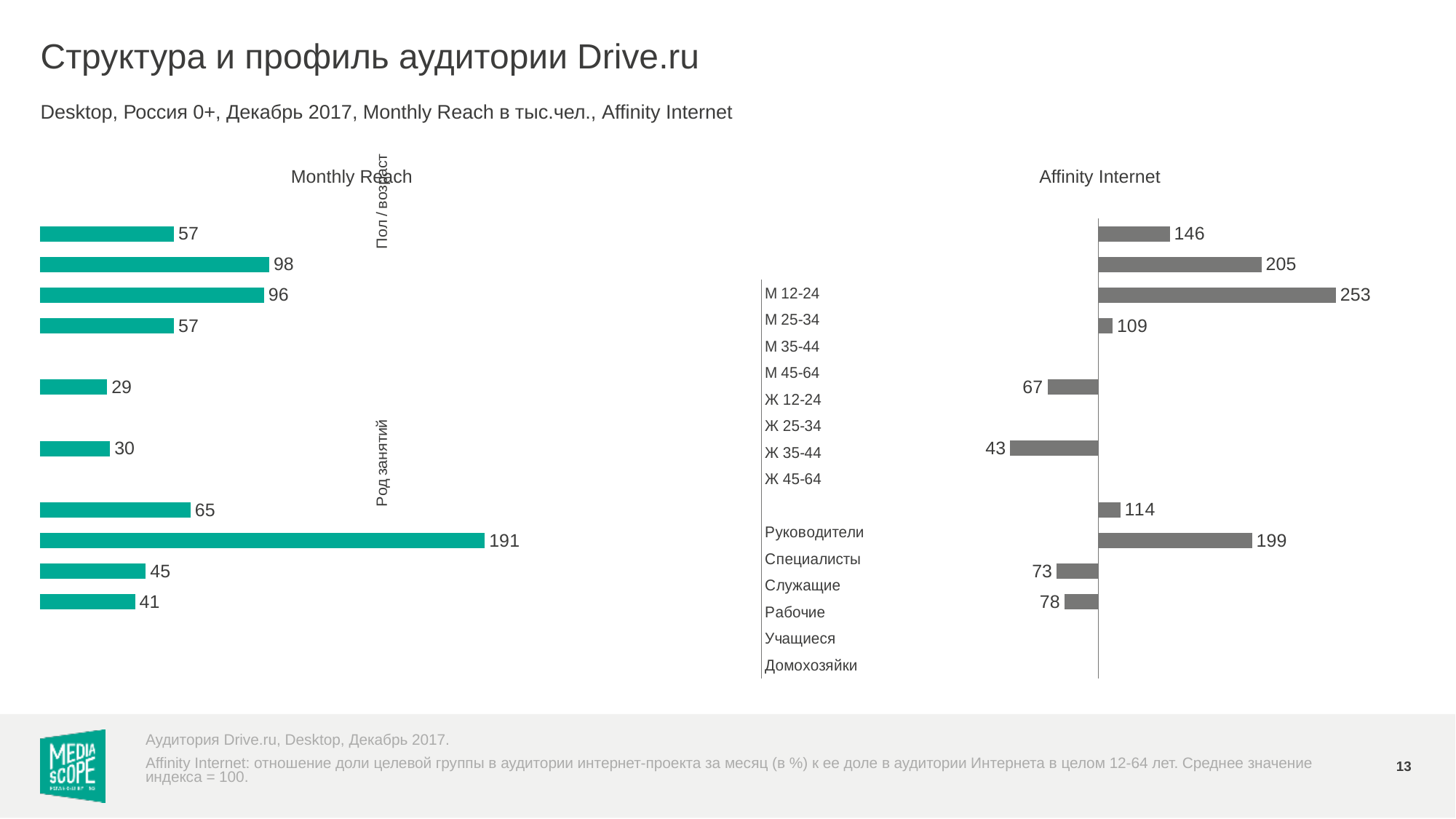
In the Affinity Internet chart, how many bars have values below 100 (extending to the left of the axis line)? 4 What kind of chart is the Monthly Reach chart on the left? bar chart In the Affinity Internet chart, what is the lowest value shown? 43 In the Monthly Reach chart, what is the value of the topmost bar? 57 In the Affinity Internet chart, what is the difference between the highest value (253) and the lowest value (43)? 210 In the Affinity Internet chart, what is the value of the bottom bar? 78 In the Monthly Reach chart, what is the value of the longest bar? 191 In the Monthly Reach chart, what is the value of the shortest bar? 29 What is the title of the chart on the right side of the slide? Affinity Internet In the Affinity Internet chart, what is the highest value shown? 253 In the Monthly Reach chart, what is the difference between the longest bar (191) and the shortest bar (29)? 162 How many bars are plotted in the Monthly Reach chart? 10